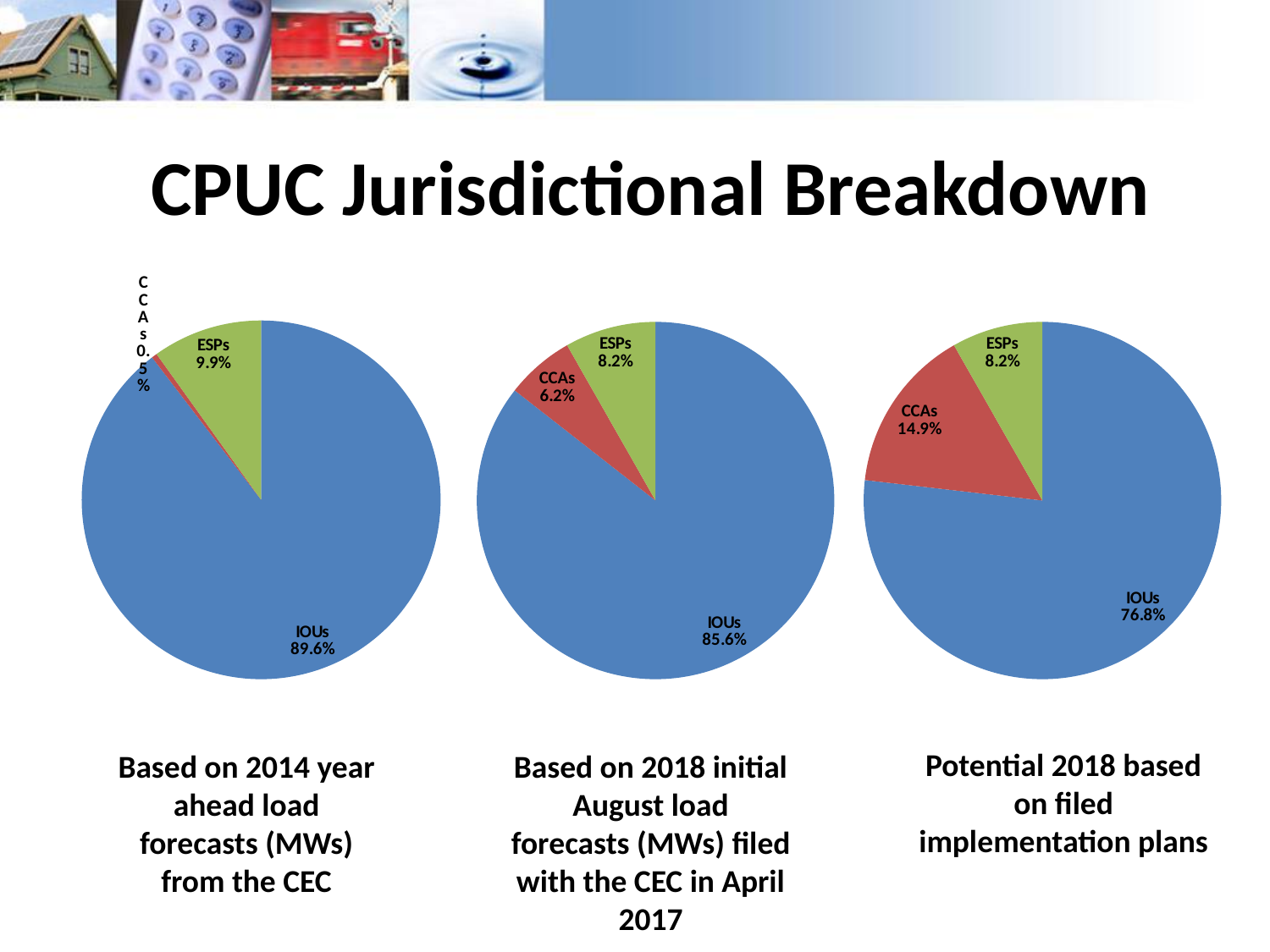
In the right pie chart, what share do IOUs have? 76.8% In the left pie chart, what share do ESPs have? 9.9% What type of chart is used on this slide? Pie chart What is the difference between the IOUs share in the left pie chart and the IOUs share in the right pie chart? 12.8% In the middle pie chart (based on 2018 initial August load forecasts), what share do CCAs have? 6.2% In the right pie chart, which category has the smallest slice? ESPs In the middle pie chart, which category has the largest slice? IOUs How many slices does each pie chart on the slide have? 3